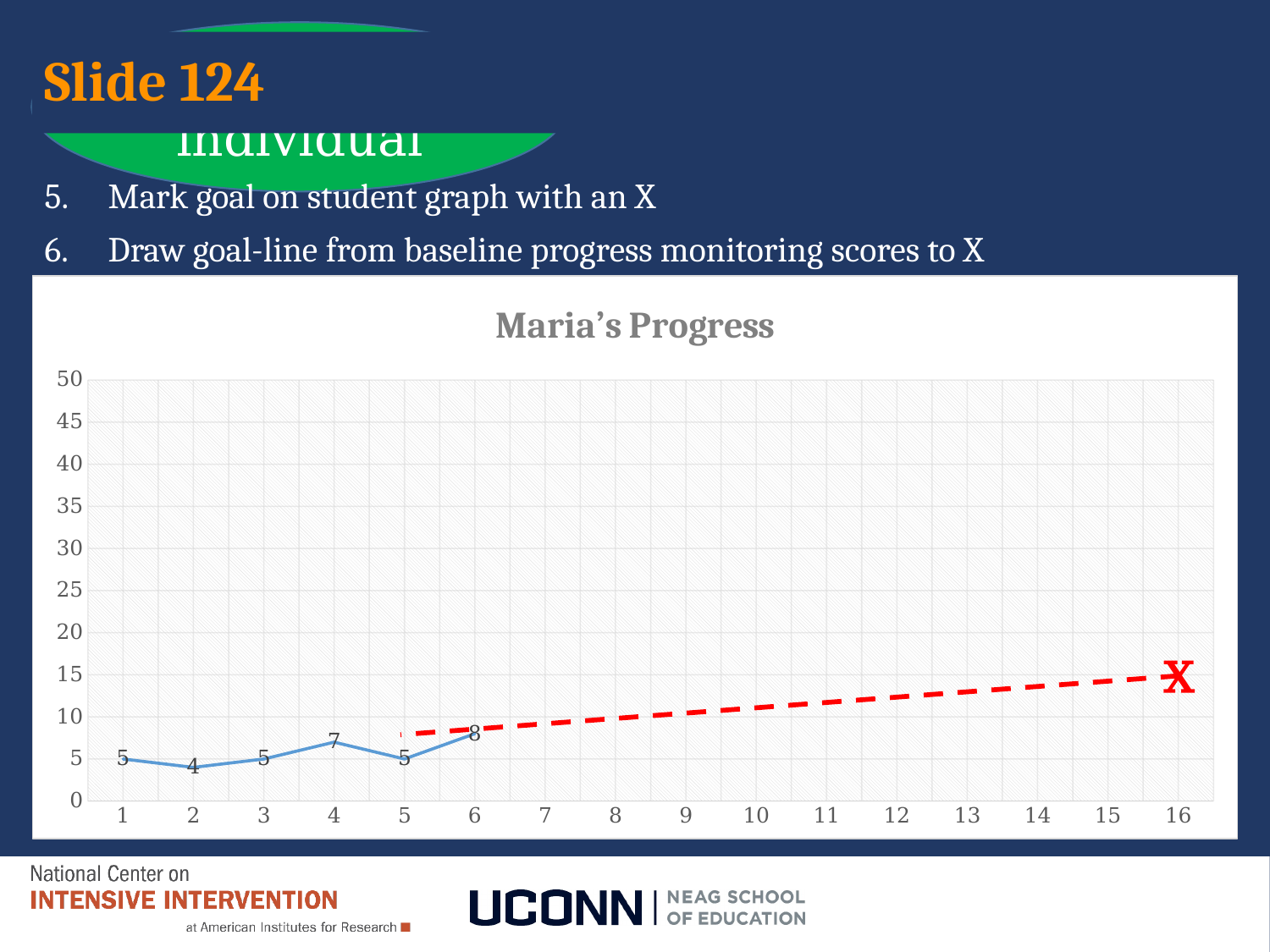
Is the goal marked with the X at point 16 greater or less than 10? greater At which point is Maria's plotted score the highest? 6 What is the title of the chart? Maria's Progress What is the difference between Maria's score at point 6 and her score at point 2? 4 Which is larger, Maria's score at point 4 or at point 5? point 4 What is Maria's score at point 4? 7 What is Maria's score at point 6? 8 What is Maria's score at point 1? 5 What is Maria's score at point 2? 4 At which point is Maria's plotted score the lowest? 2 What kind of chart is shown on the slide? line chart How many data points are plotted on the blue line? 6